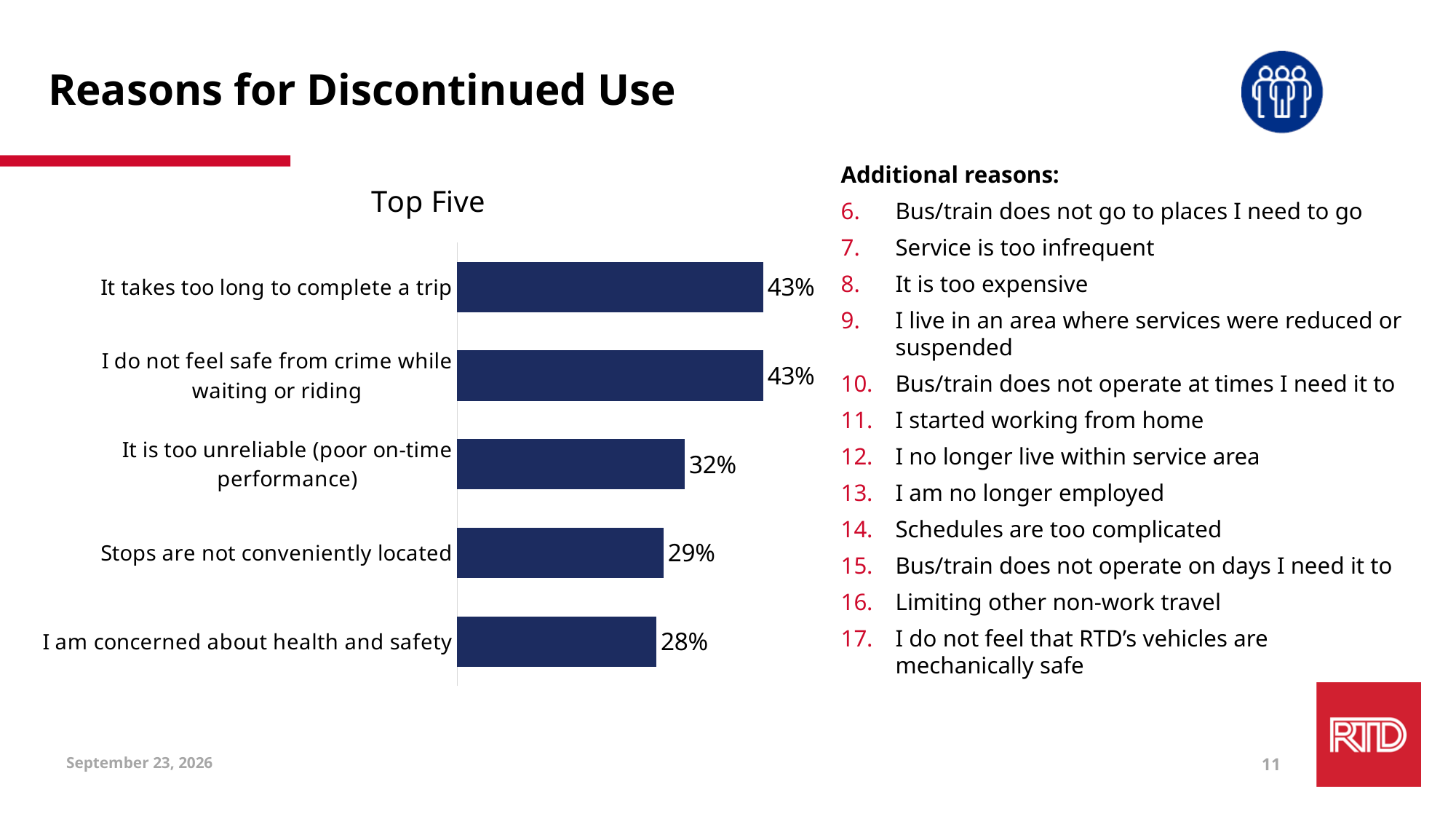
What is the value for "I am concerned about health and safety"? 28% How many categories are shown in the chart? 5 What is the value for "It is too unreliable (poor on-time performance)"? 32% What is the difference between the values for "It takes too long to complete a trip" and "It is too unreliable (poor on-time performance)"? 11% Which is larger: the value for "It is too unreliable (poor on-time performance)" or for "Stops are not conveniently located"? It is too unreliable (poor on-time performance) What percentage is shown for "Stops are not conveniently located"? 29% What percentage is shown for "It takes too long to complete a trip"? 43% Which category has the lowest value in the chart? I am concerned about health and safety What is the title of the chart? Top Five What is the value for "I do not feel safe from crime while waiting or riding"? 43% What kind of chart is shown on the slide? Bar chart What is the difference between "Stops are not conveniently located" and "I am concerned about health and safety"? 1%